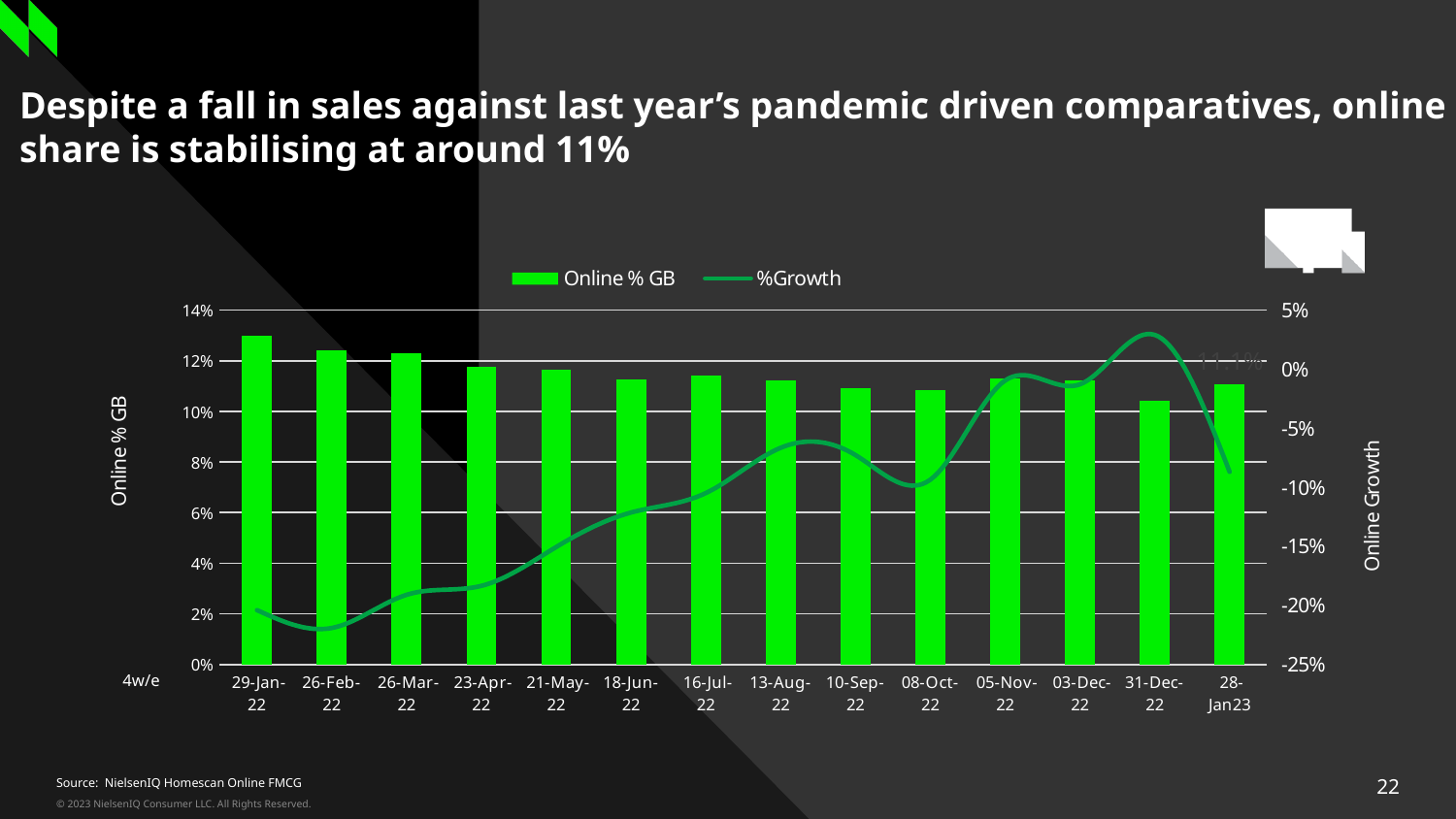
Is the Online % GB value for 18-Jun-22 greater or less than 12%? less What are the two series named in the chart legend? Online % GB and %Growth Is the Online % GB value for 08-Oct-22 greater or less than 10%? greater Which is larger, the Online % GB bar for 29-Jan-22 or for 28-Jan23? 29-Jan-22 Is the Online % GB value for 29-Jan-22 greater or less than 12%? greater What is the title of the right-hand vertical axis? Online Growth Do the Online % GB bars generally rise or fall from 29-Jan-22 to 28-Jan23? fall How many time periods are shown along the x axis of the chart? 14 How many series does the chart legend list? 2 Which period has the highest Online % GB bar? 29-Jan-22 What kind of chart is shown on the slide? A combined bar and line chart